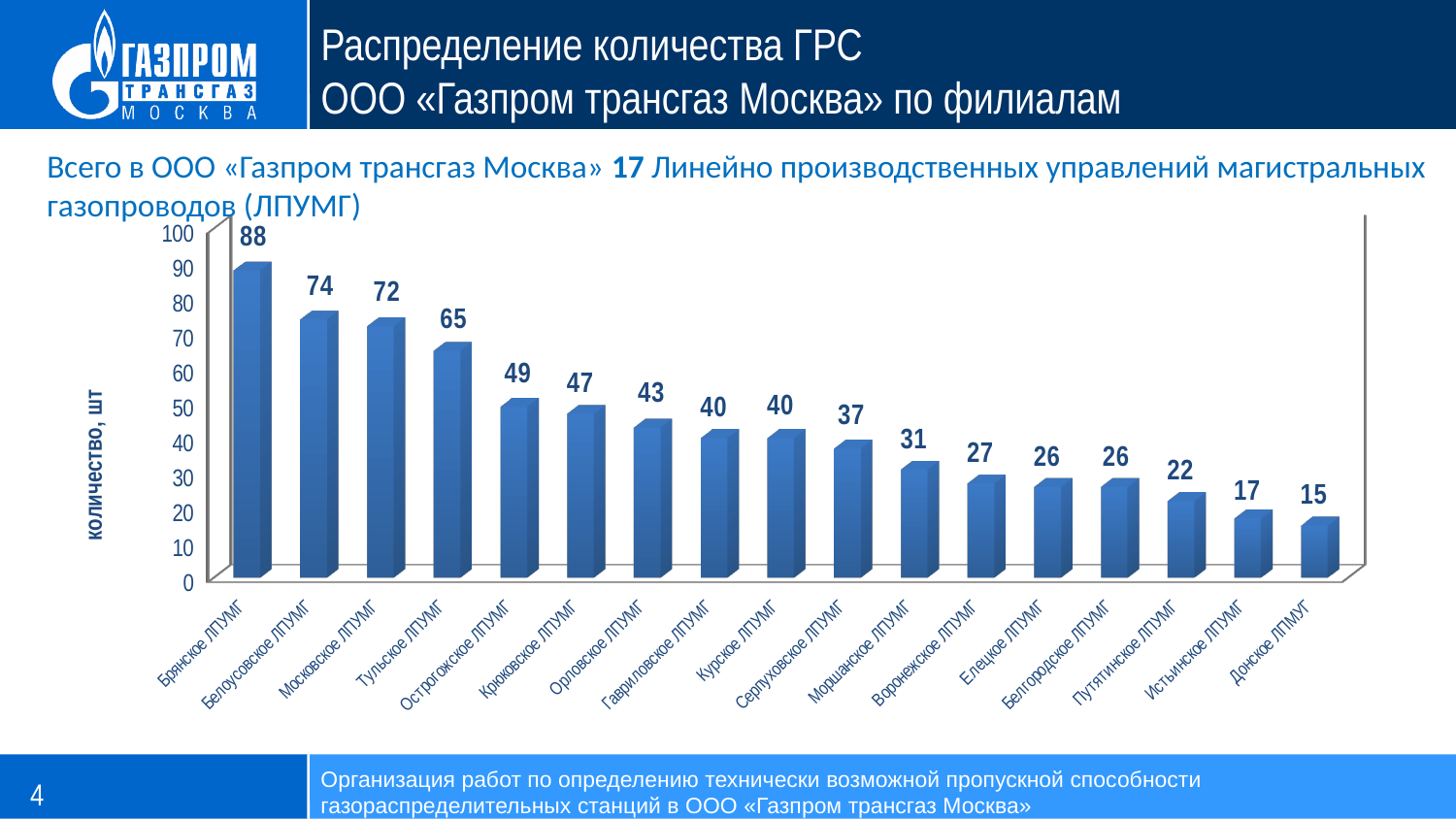
What is the value for Тульское ЛПУМГ? 65 What is the value for Серпуховское ЛПУМГ? 37 What is the difference between the values for Белоусовское ЛПУМГ and Московское ЛПУМГ? 2 What is the value for Брянское ЛПУМГ? 88 Which is larger, the value for Острогожское ЛПУМГ or Крюковское ЛПУМГ? Острогожское ЛПУМГ What is the label of the vertical axis? количество, шт What kind of chart is shown on the slide? Bar chart Which branch has the lowest number of ГРС? Донское ЛПМУГ Do the values rise or fall from left to right along the x axis? Fall How many branches (categories) are shown on the chart? 17 Which branch has the highest number of ГРС? Брянское ЛПУМГ What is the difference between the values for Брянское ЛПУМГ and Донское ЛПМУГ? 73